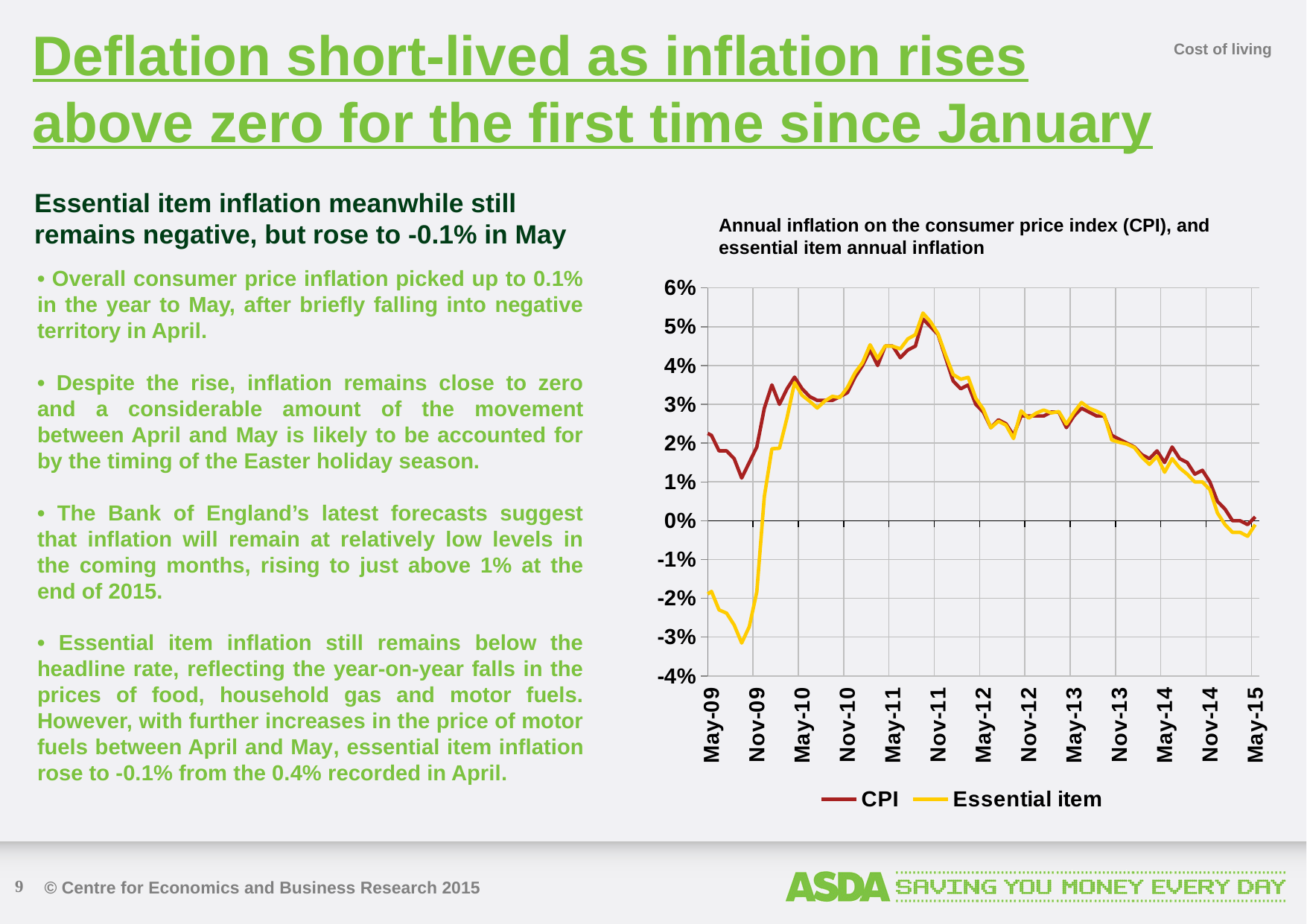
Is the CPI value at Nov-11 greater or less than 4%? greater Around which x-axis label does the Essential item line reach its lowest point? Nov-09 Around which x-axis label does the CPI line reach its highest point? Nov-11 What are the two series named in the chart legend? CPI and Essential item Is the Essential item value at May-09 greater or less than 0%? less At Nov-09, which series has the higher value, CPI or Essential item? CPI How many date labels are shown on the x axis of the chart? 13 Is the CPI value at May-15 greater or less than 1%? less Does the CPI line generally rise or fall between Nov-11 and May-15? Fall How many series does the chart legend list? 2 What colour is the Essential item line in the chart? Yellow What kind of chart is shown on the slide? Line chart